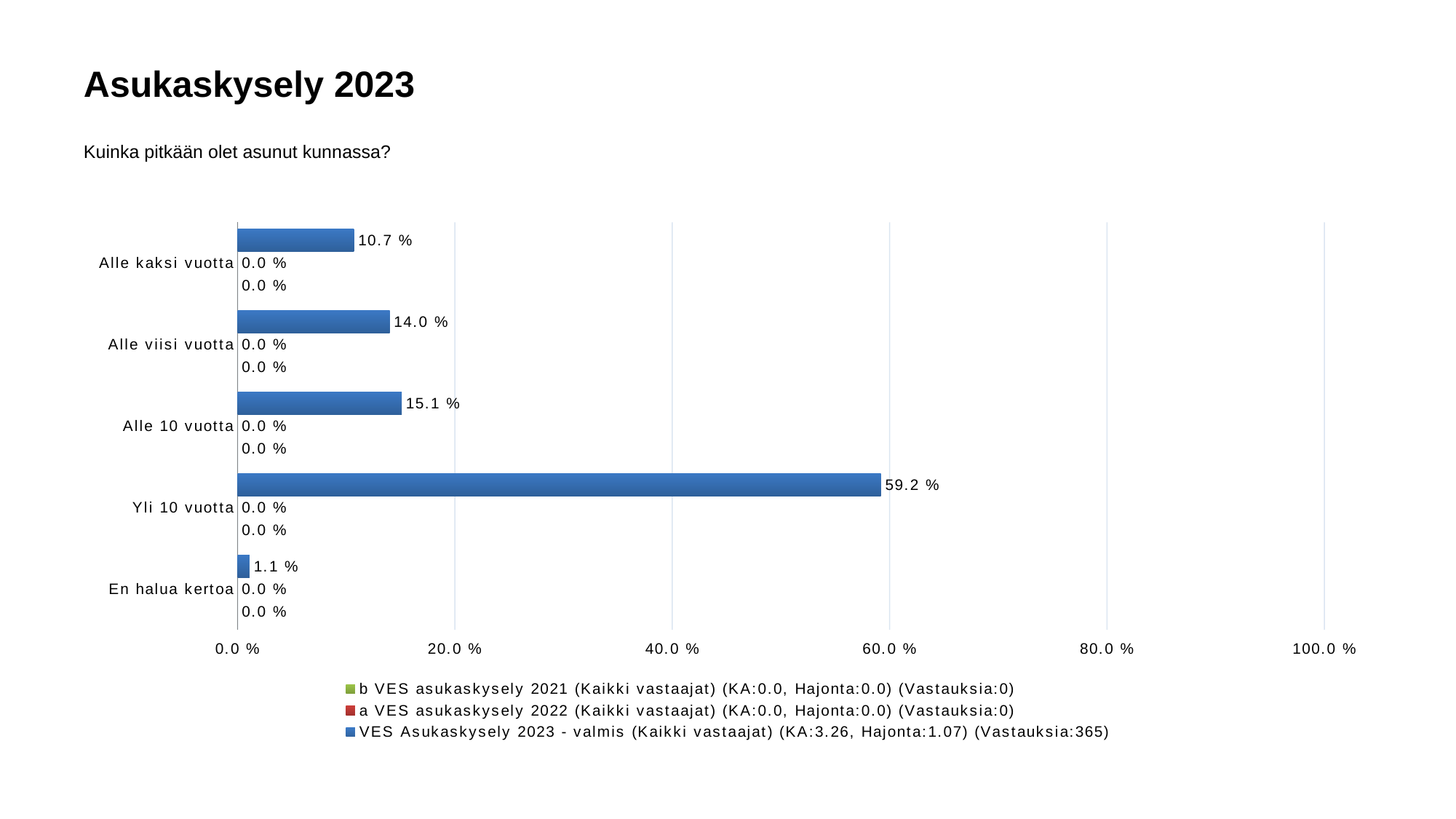
Which category has the highest value in the 2023 series? Yli 10 vuotta Which category has the lowest value in the 2023 series? En halua kertoa What is the value for "Yli 10 vuotta" in the 2023 series? 59.2 % What is the value for "Alle 10 vuotta" in the 2022 series? 0.0 % What is the value for "Alle kaksi vuotta" in the 2023 series? 10.7 % How many categories are shown on the chart? 5 What is the difference between "Alle 10 vuotta" and "Alle viisi vuotta" in the 2023 series? 1.1 % What kind of chart is shown on the slide? bar chart Is the value for "Yli 10 vuotta" in the 2023 series greater or less than 40.0 %? greater How many series does the legend list? 3 What is the value for "En halua kertoa" in the 2023 series? 1.1 % Which is larger in the 2023 series: "Alle viisi vuotta" or "Alle kaksi vuotta"? Alle viisi vuotta